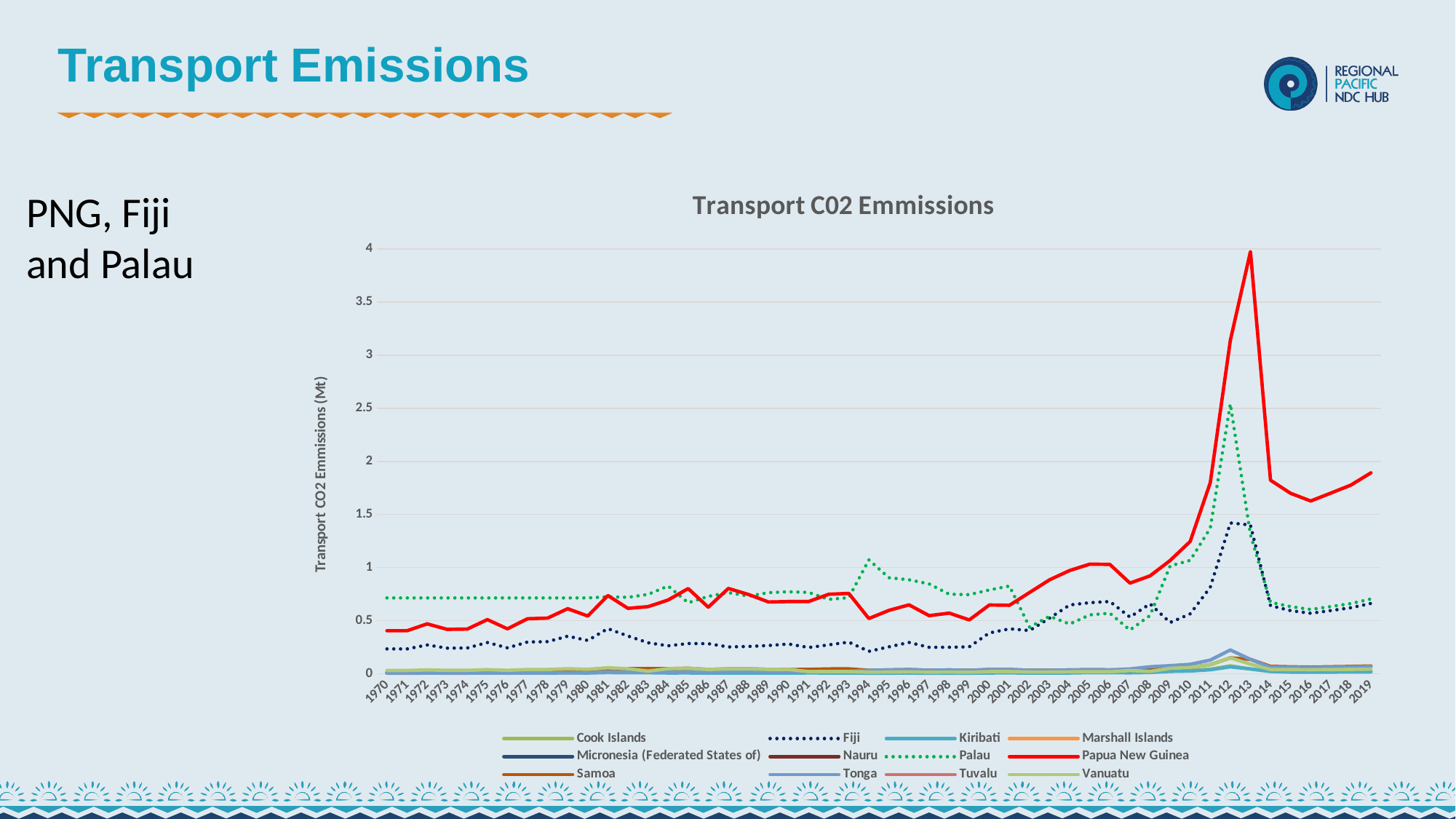
Which series reaches the highest value on the chart? Papua New Guinea Is the value for Papua New Guinea in 2013 greater or less than 3.5? greater In 2013, which is larger: the value for Papua New Guinea or the value for Palau? Papua New Guinea In 1994, which is larger: the value for Palau or the value for Papua New Guinea? Palau Is the value for Palau in 2012 greater or less than 2? greater What kind of chart is shown on the slide? line chart Does the Papua New Guinea line rise or fall between 2013 and 2016? fall In which year does the Papua New Guinea line reach its peak? 2013 What is the title of the chart? Transport C02 Emmissions Is the value for Fiji in 1970 greater or less than 0.5? less How many years are shown along the x axis of the chart? 50 How many series does the legend of the chart list? 12